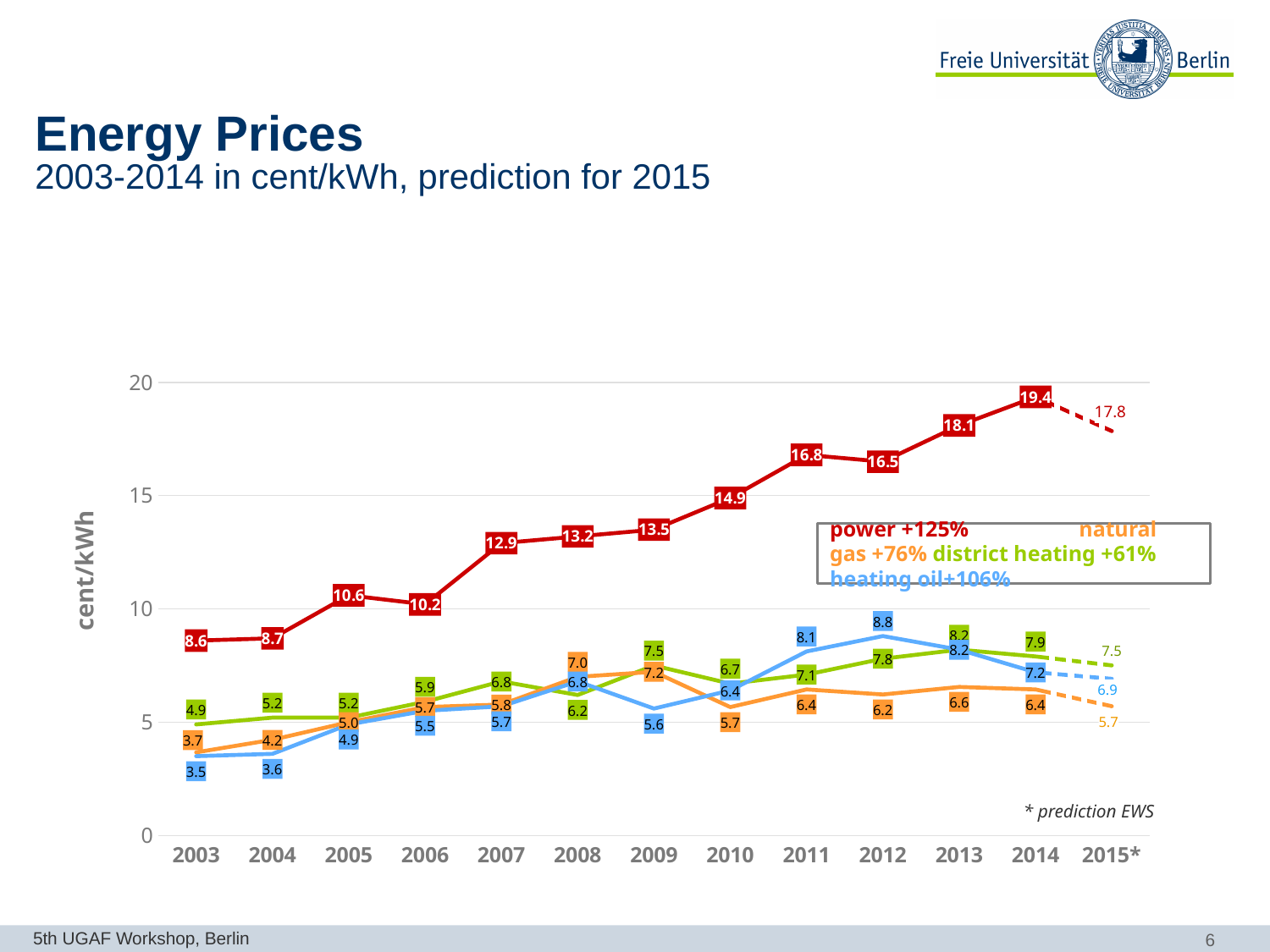
What was the heating oil price in 2012? 8.8 Which series had the lowest value in 2003? heating oil Does the power price generally rise or fall from 2003 to 2014? rise In which year did the power price reach its highest value? 2014 Which was higher in 2011, the heating oil price or the natural gas price? heating oil What was the power price in 2014? 19.4 What is the predicted power price for 2015? 17.8 How many series does the legend list? 4 By how much did the power price increase from 2003 to 2014? 10.8 What type of chart is shown on the slide? line chart What percentage increase does the legend give for heating oil? +106% What was the district heating price in 2003? 4.9